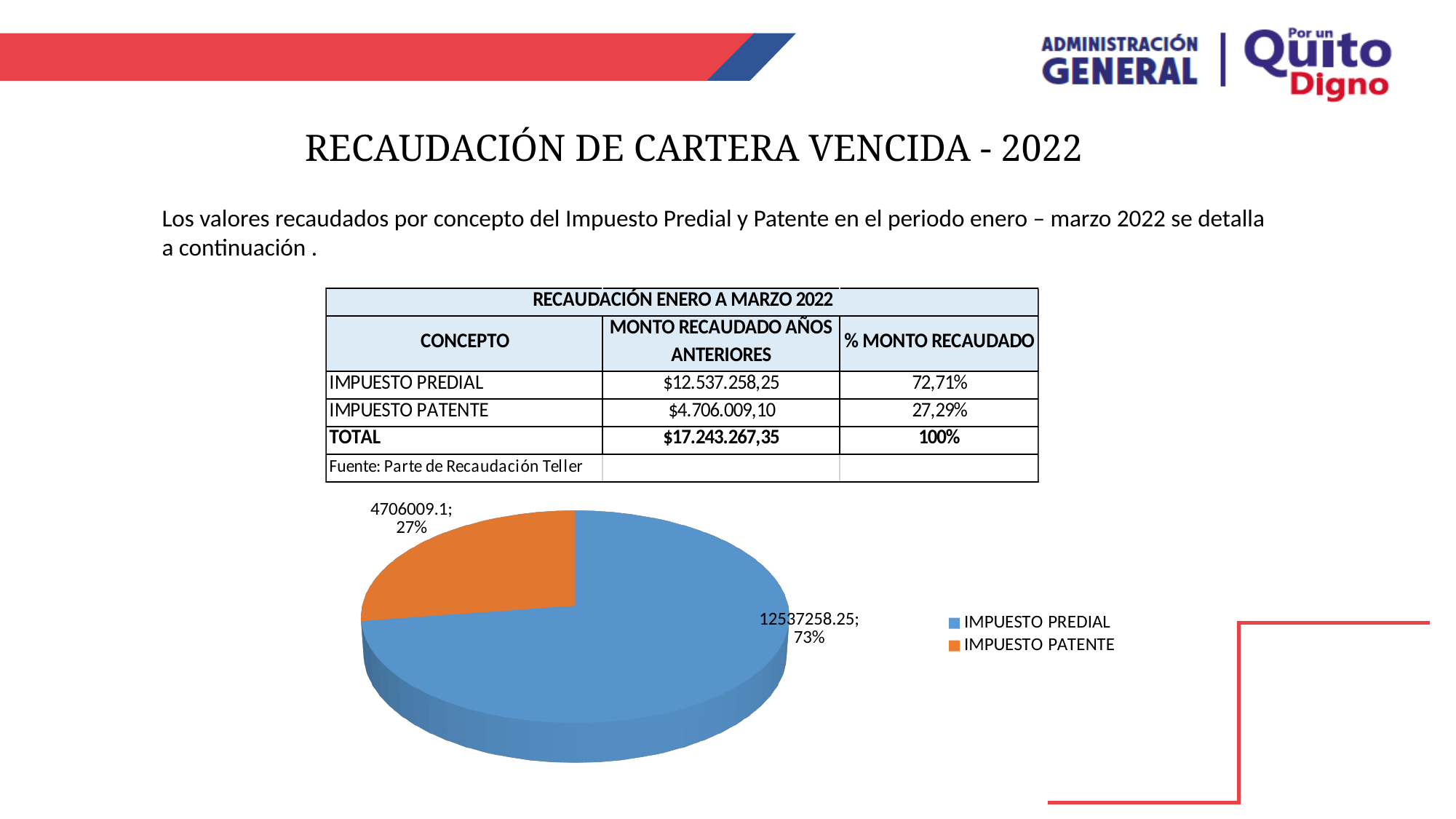
Which category has the largest slice in the pie chart? IMPUESTO PREDIAL Which category has the smallest slice in the pie chart? IMPUESTO PATENTE What percentage share of the pie does IMPUESTO PATENTE have? 27% What value is shown for IMPUESTO PREDIAL in the pie chart? 12537258.25 What percentage share of the pie does IMPUESTO PREDIAL have? 73% What kind of chart is shown on the slide? pie chart What value is shown for IMPUESTO PATENTE in the pie chart? 4706009.1 What colour is the IMPUESTO PREDIAL slice in the pie chart? blue Which is larger in the pie chart, IMPUESTO PREDIAL or IMPUESTO PATENTE? IMPUESTO PREDIAL What colour is the IMPUESTO PATENTE slice in the pie chart? orange How many slices does the pie chart have? 2 How many entries does the legend of the pie chart list? 2